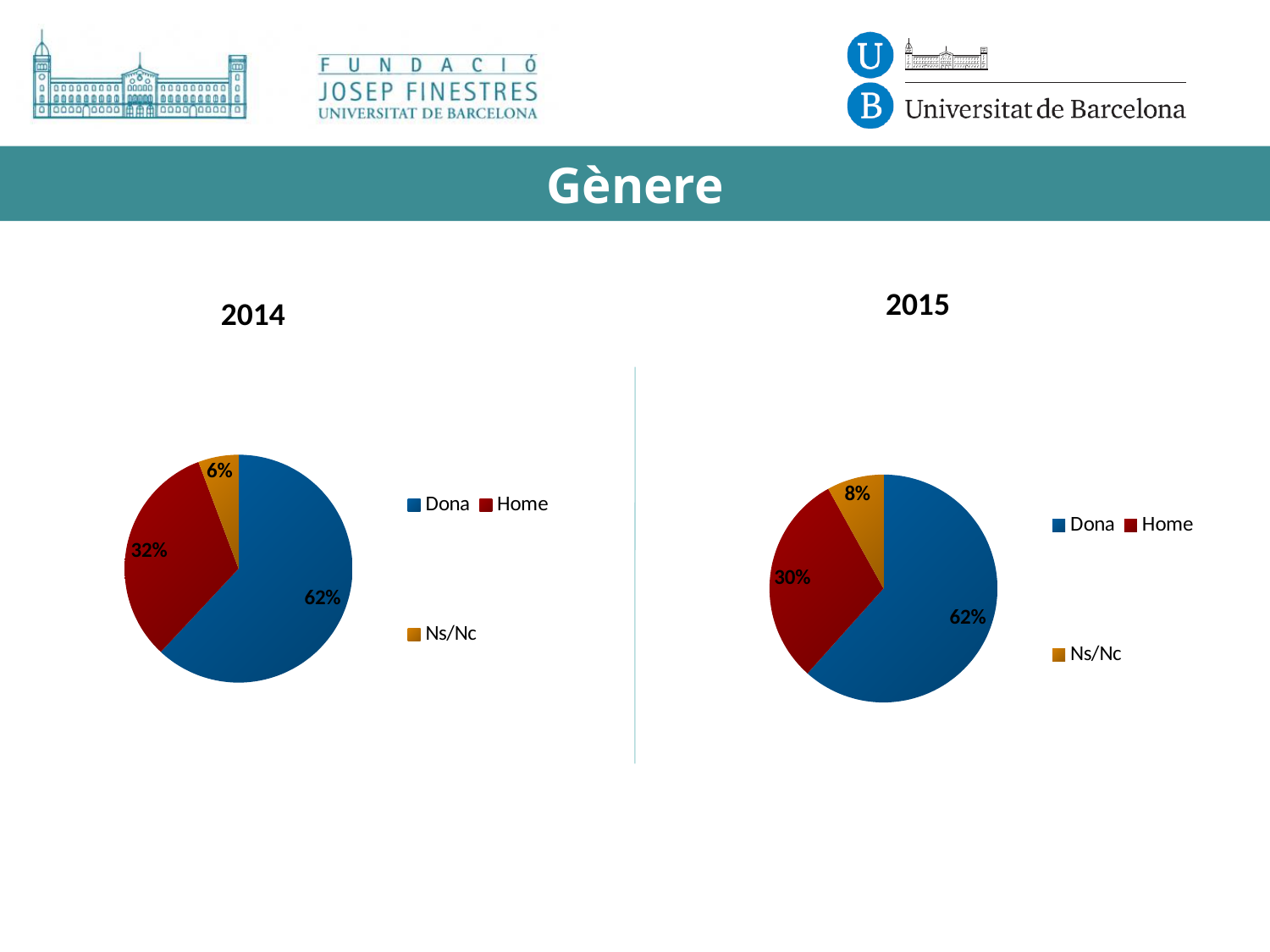
In the 2015 chart, what share does Ns/Nc have? 8% In the 2015 chart, which category has the largest slice? Dona In the 2015 chart, which is larger, Home or Ns/Nc? Home In the 2014 chart, what is the difference between the Dona and Home shares? 30% In the 2015 chart, what share does Home have? 30% What kind of chart is the 2014 chart? Pie chart In the 2014 chart, what share does Dona have? 62% How many categories does the 2015 chart show? 3 In the 2014 chart, what share does Ns/Nc have? 6% In the 2014 chart, which category has the smallest slice? Ns/Nc What colour represents Home in the 2015 chart? Red In the 2014 chart, what share does Home have? 32%